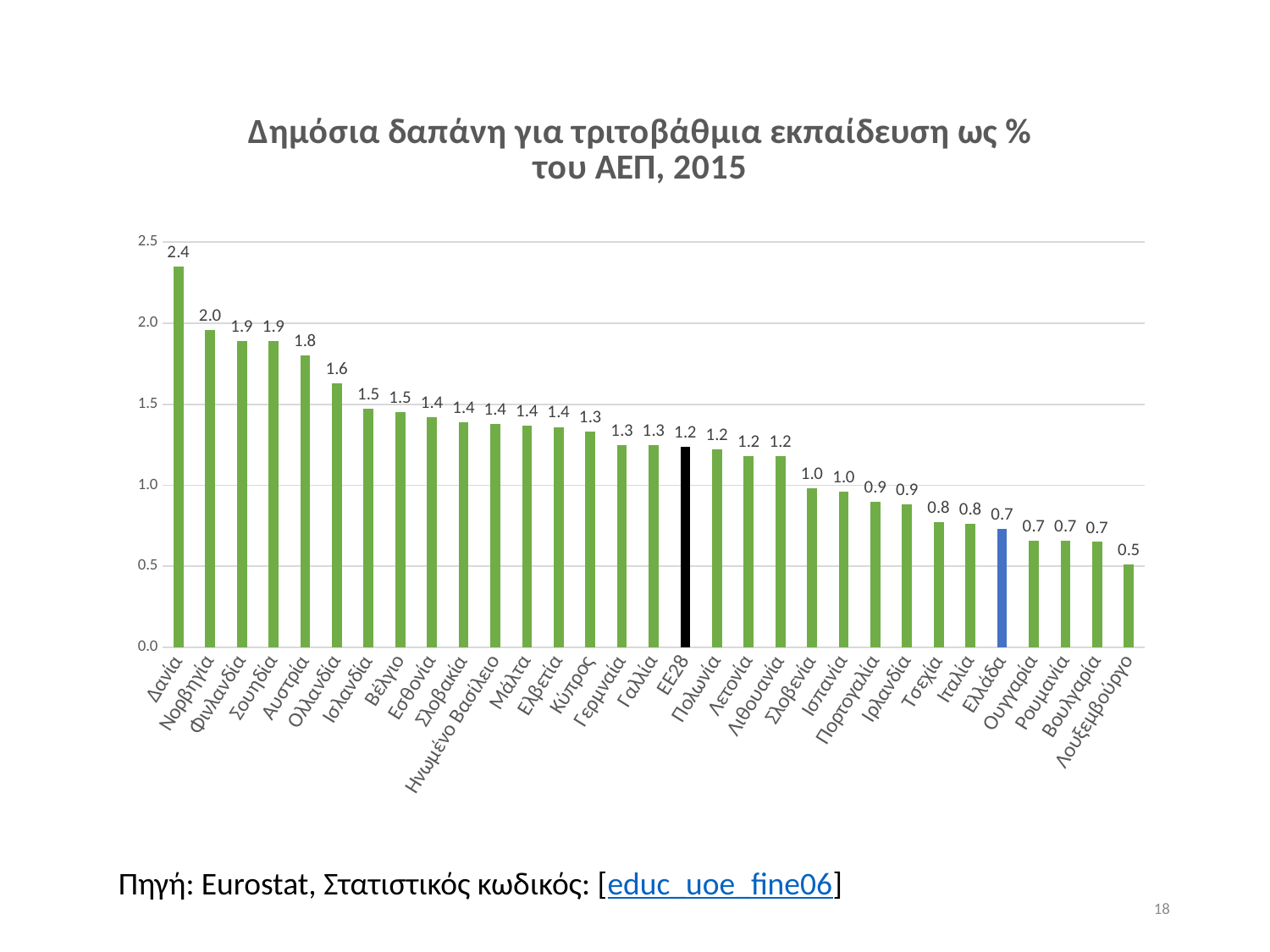
What is the difference between the values for Δανία and Ελλάδα? 1.7 What colour is the bar for Ελλάδα? blue What is the value for Δανία? 2.4 What is the value for Ελλάδα? 0.7 Which country has the highest value? Δανία Which country has the lowest value? Λουξεμβούργο How many bars are shown in the chart? 31 What is the value for ΕΕ28? 1.2 Which has a larger value, Νορβηγία or Αυστρία? Νορβηγία Is the value for Ολλανδία greater or less than 1.5? greater What is the difference between the values for Δανία and Λουξεμβούργο? 1.9 What kind of chart is shown on the slide? bar chart